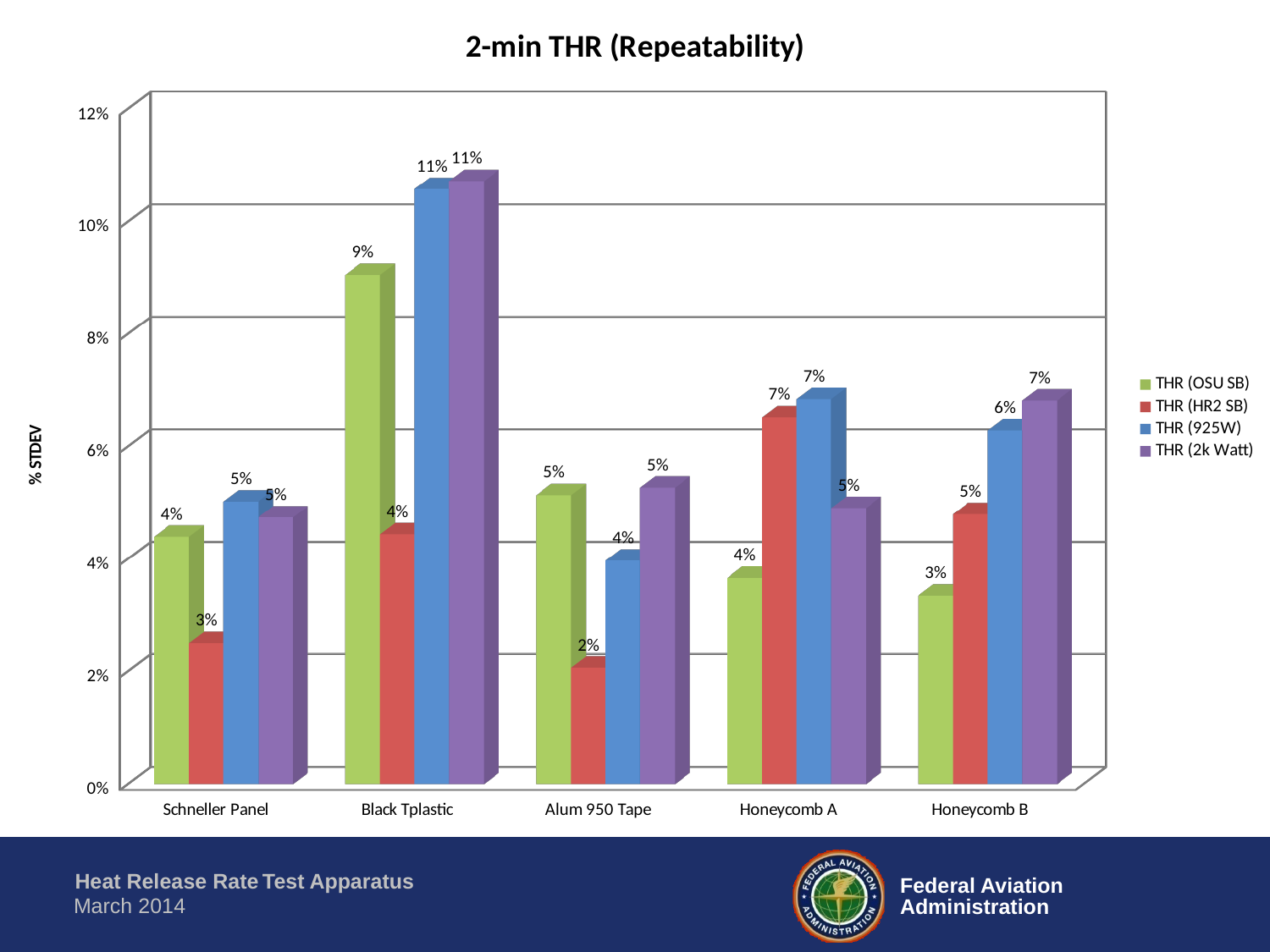
How many material categories are shown on the x axis? 5 Which category has the lowest THR (HR2 SB) value? Alum 950 Tape What is the THR (2k Watt) value for Honeycomb A? 5% How many series does the legend list? 4 What is the THR (925W) value for Honeycomb B? 6% What is the THR (HR2 SB) value for Alum 950 Tape? 2% Which category has the highest THR (OSU SB) value? Black Tplastic What kind of chart is shown on the slide? Bar chart Which has the larger THR (HR2 SB) value, Honeycomb A or Honeycomb B? Honeycomb A For Black Tplastic, what is the difference between the THR (OSU SB) value and the THR (HR2 SB) value? 5 percentage points Is the THR (925W) value for Black Tplastic greater or less than 10%? greater What is the THR (OSU SB) value for Black Tplastic? 9%